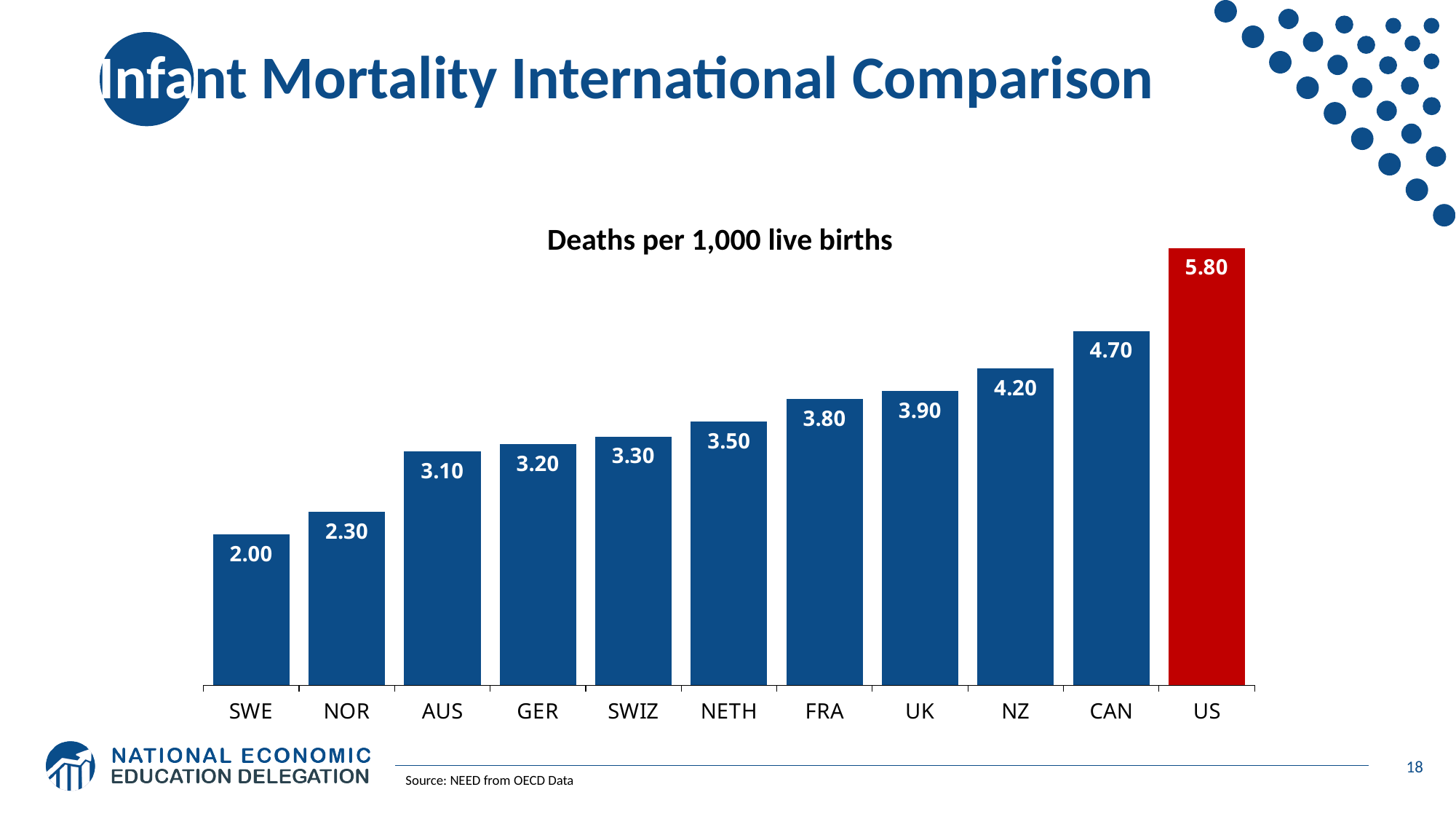
What is the value for NETH in the chart? 3.50 What is the difference between the values for the US and CAN? 1.10 Which country has the highest infant mortality rate in the chart? US What kind of chart is shown on the slide? Bar chart What is the difference between the values for NOR and SWE? 0.30 What is the value for the US in the chart? 5.80 What is the value for GER in the chart? 3.20 Which bar is coloured red rather than blue? US Do the values rise or fall from left to right across the chart? Rise Which country has the lowest infant mortality rate in the chart? SWE How many countries are shown in the chart? 11 Which has a higher value, UK or FRA? UK